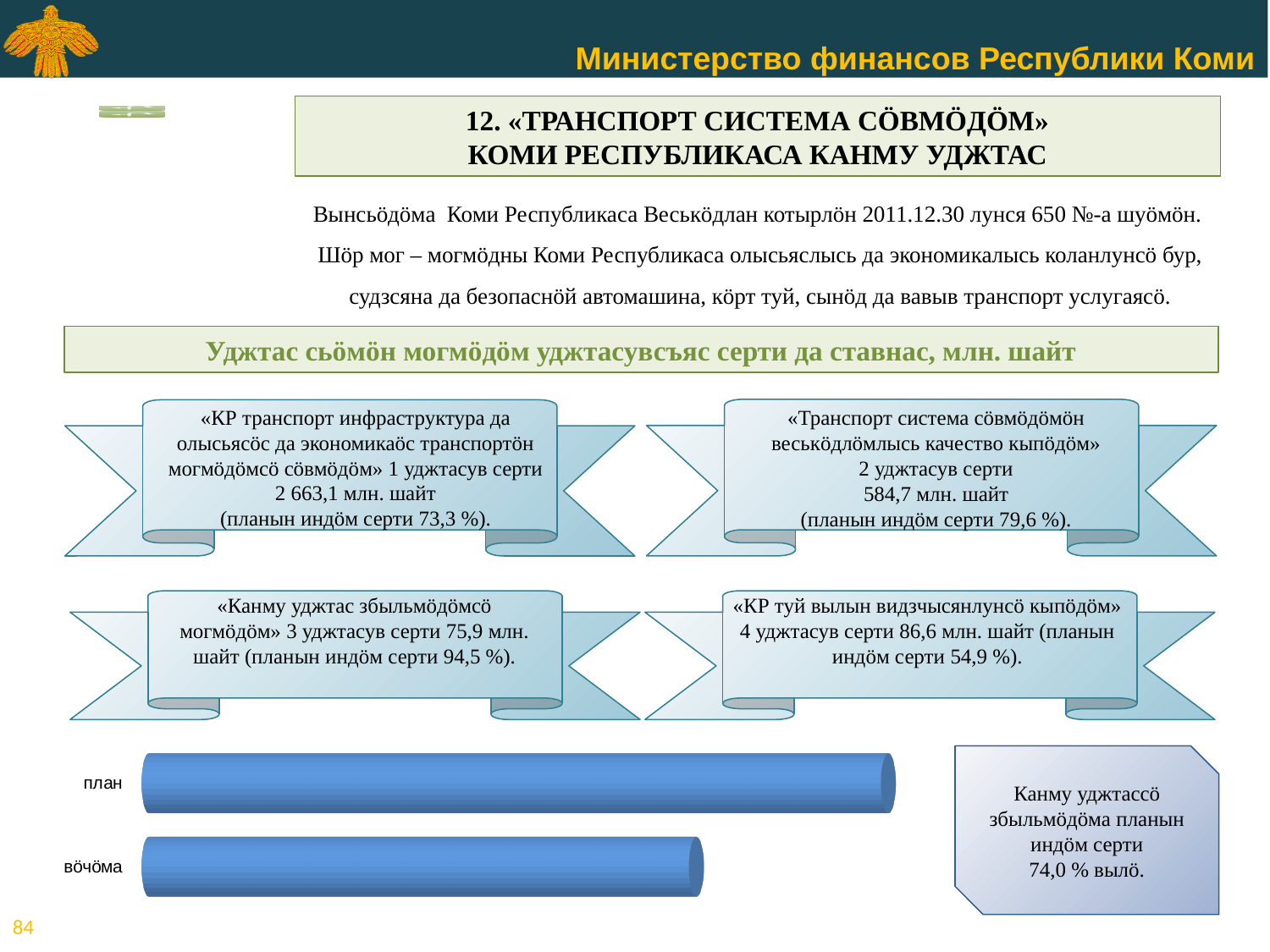
Which category has the longer bar in the chart at the bottom of the slide? план Are the bars in the chart at the bottom of the slide horizontal or vertical? horizontal In the chart at the bottom of the slide, is the bar for план longer or shorter than the bar for вöчöма? longer How many bars does the chart at the bottom of the slide have? 2 Which category has the shorter bar in the chart at the bottom of the slide? вöчöма What are the two category labels on the chart at the bottom of the slide? план and вöчöма What kind of chart is shown at the bottom of the slide? bar chart In the chart at the bottom of the slide, is the bar for вöчöма longer or shorter than the bar for план? shorter